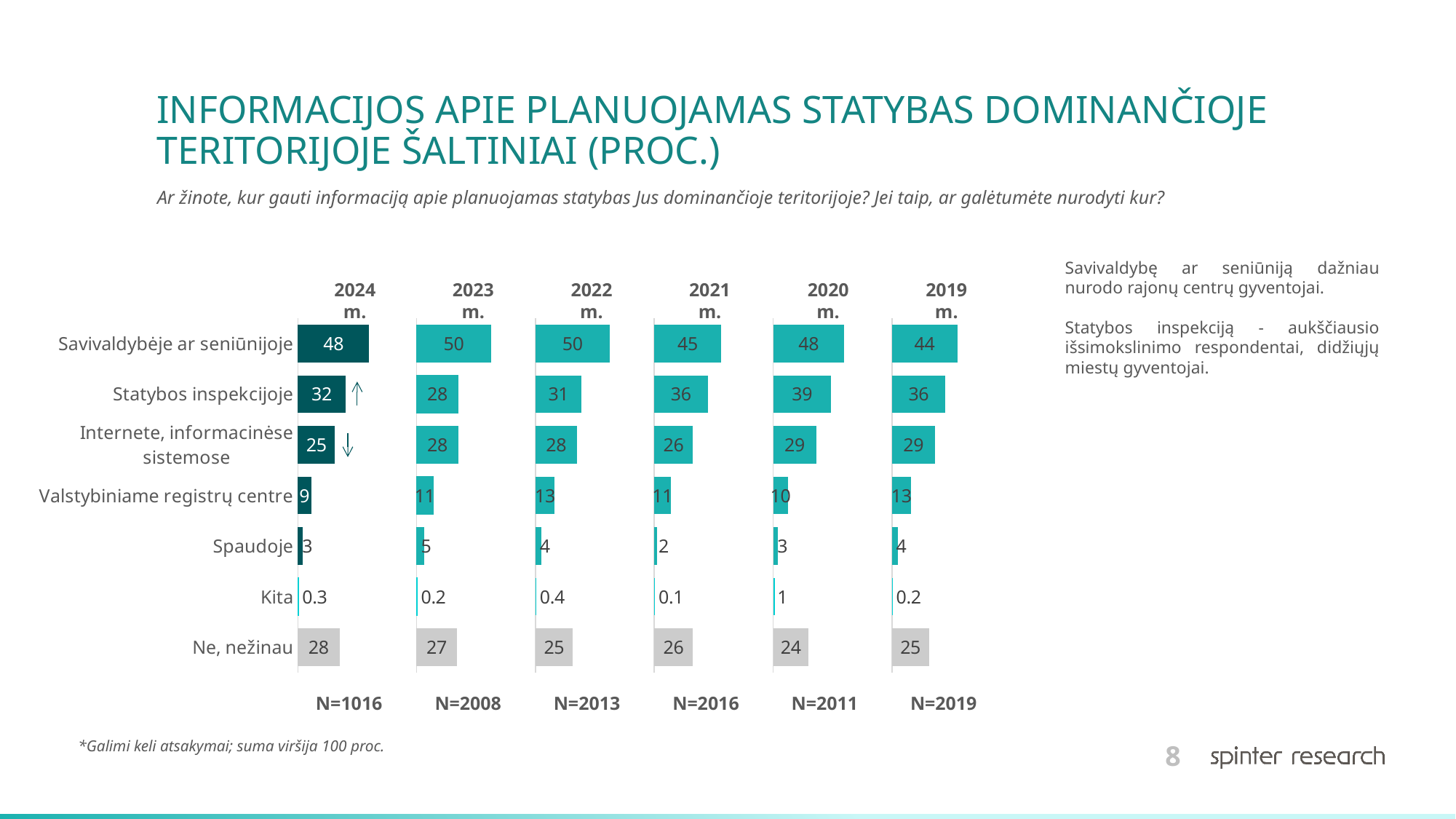
In the 2020 m. chart, what is the value for Statybos inspekcijoje? 39 In the 2021 m. chart, which is larger: Valstybiniame registrų centre or Spaudoje? Valstybiniame registrų centre In the 2022 m. chart, which category has the highest value? Savivaldybėje ar seniūnijoje In the 2024 m. chart, what is the value for Savivaldybėje ar seniūnijoje? 48 How many year charts are shown on the slide? 6 Across the charts from 2019 m. to 2024 m., what is the difference between the Spaudoje value in 2023 m. and in 2021 m.? 3 In the 2023 m. chart, which category has the lowest value? Kita In the 2019 m. chart, what is the value for Ne, nežinau? 25 In the 2021 m. chart, what is the value for Kita? 0.1 What kind of chart is used for each year on the slide? Bar chart How many categories does each year's chart show? 7 In the 2024 m. chart, what is the difference between Statybos inspekcijoje and Internete, informacinėse sistemose? 7